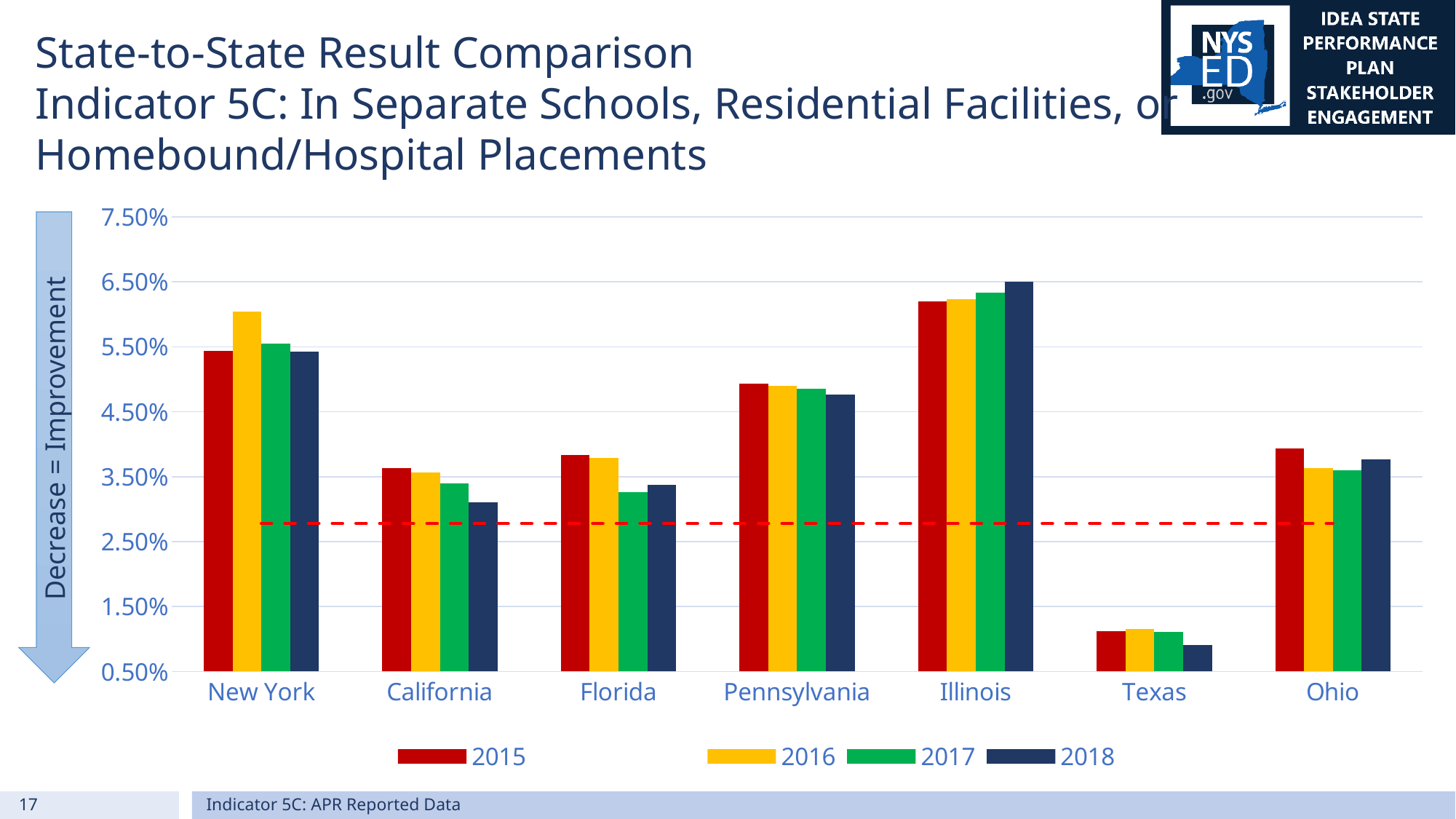
Is the 2016 value for New York greater or less than 5.50%? greater Is the 2018 value for Texas greater or less than 1.50%? less Which state has the highest value for 2018? Illinois How many states are shown on the x axis of the chart? 7 Is the 2018 value for Illinois greater or less than 5.50%? greater Which state has the lowest value for 2018? Texas Which is larger, the 2016 value for New York or the 2016 value for Pennsylvania? New York How many series does the chart's legend list? 4 Do the values for Illinois rise or fall from 2015 to 2018? rise What colour represents the 2015 series in the legend? red What kind of chart is shown on the slide? bar chart Do the values for California rise or fall from 2015 to 2018? fall